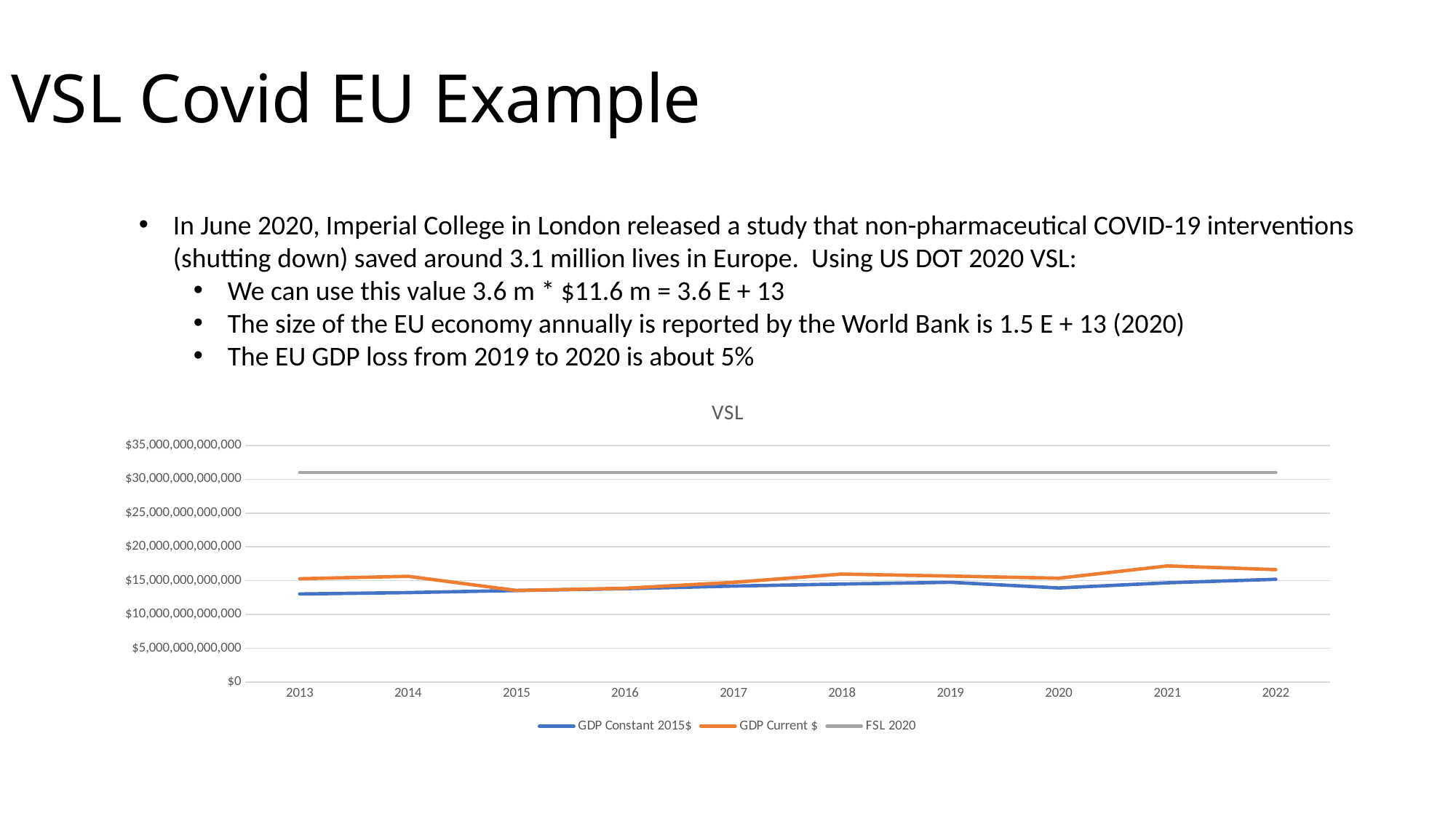
How many years are shown on the x axis of the chart? 10 In 2021, which is larger: GDP Current $ or GDP Constant 2015$? GDP Current $ Which series in the chart has the highest values across all years? FSL 2020 How many series does the chart legend list? 3 In which year is the GDP Constant 2015$ series at its lowest value? 2013 In which year does the GDP Current $ series reach its highest value? 2021 Does the FSL 2020 line rise, fall, or stay flat from 2013 to 2022? Stays flat Is the value for GDP Current $ in 2021 greater or less than $15,000,000,000,000? greater Is the value for GDP Constant 2015$ in 2013 greater or less than $15,000,000,000,000? less What kind of chart is shown on the slide? Line chart Is the value of the FSL 2020 line greater or less than $30,000,000,000,000? greater What is the title of the chart? VSL